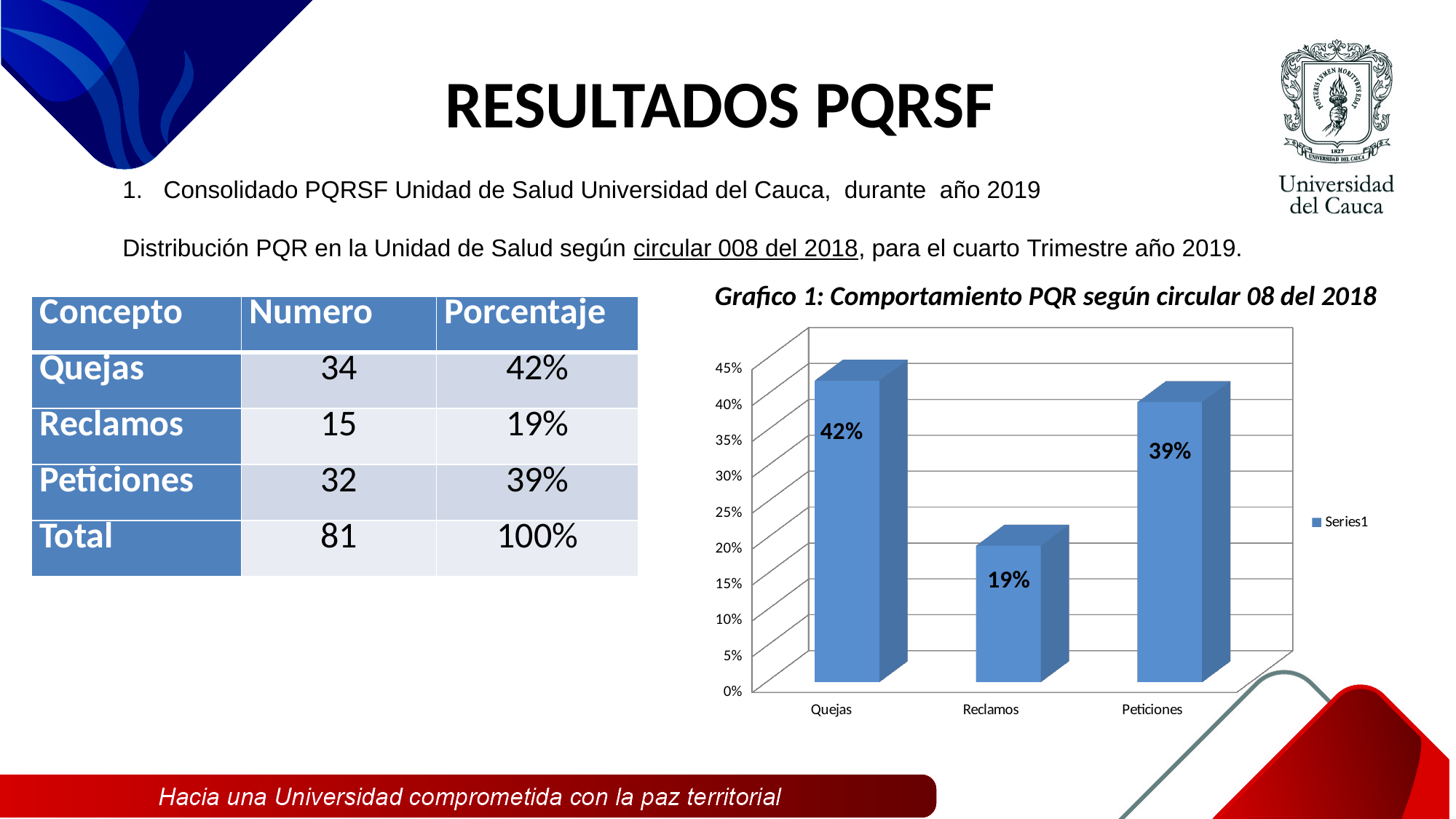
Is the value for Reclamos greater or less than 25%? less What is the difference between the values for Quejas and Reclamos? 23% What is the value for Reclamos in the chart? 19% What is the value for Quejas in the chart? 42% What is the title of the chart? Grafico 1: Comportamiento PQR según circular 08 del 2018 Which is larger, the value for Quejas or the value for Peticiones? Quejas Which category has the lowest value in the chart? Reclamos Which category has the highest value in the chart? Quejas What is the value for Peticiones in the chart? 39% What is the difference between the values for Peticiones and Reclamos? 20% What kind of chart is shown on the slide? bar chart How many categories are shown on the x axis of the chart? 3